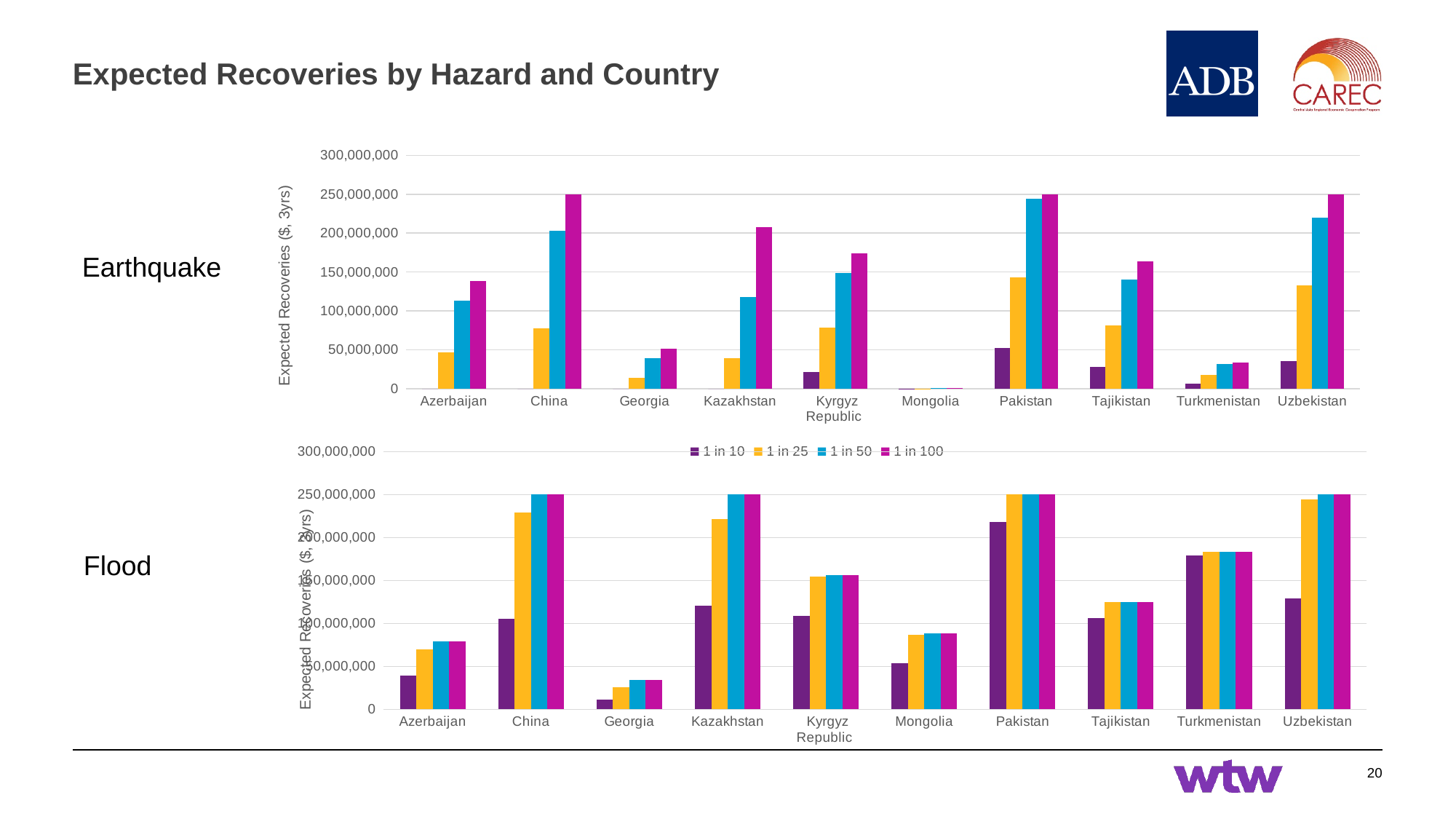
On the Earthquake chart, is the 1 in 25 value for Tajikistan greater or less than 100,000,000? less On the Flood chart, is the 1 in 100 value for Mongolia greater or less than 100,000,000? less What kind of chart is the Earthquake chart? bar chart On the Flood chart, which country has the lowest expected recoveries across all return periods? Georgia On the Earthquake chart, which country has the lowest expected recoveries across all return periods? Mongolia What are the four series listed in the legend? 1 in 10, 1 in 25, 1 in 50, 1 in 100 On the Earthquake chart, which is larger: the 1 in 50 value for China or the 1 in 50 value for Kyrgyz Republic? China On the Flood chart, is the 1 in 10 value for Turkmenistan greater or less than 150,000,000? greater How many series does the legend list? 4 On the Flood chart, which is larger: the 1 in 10 value for Pakistan or the 1 in 10 value for Uzbekistan? Pakistan How many countries are shown on the Flood chart? 10